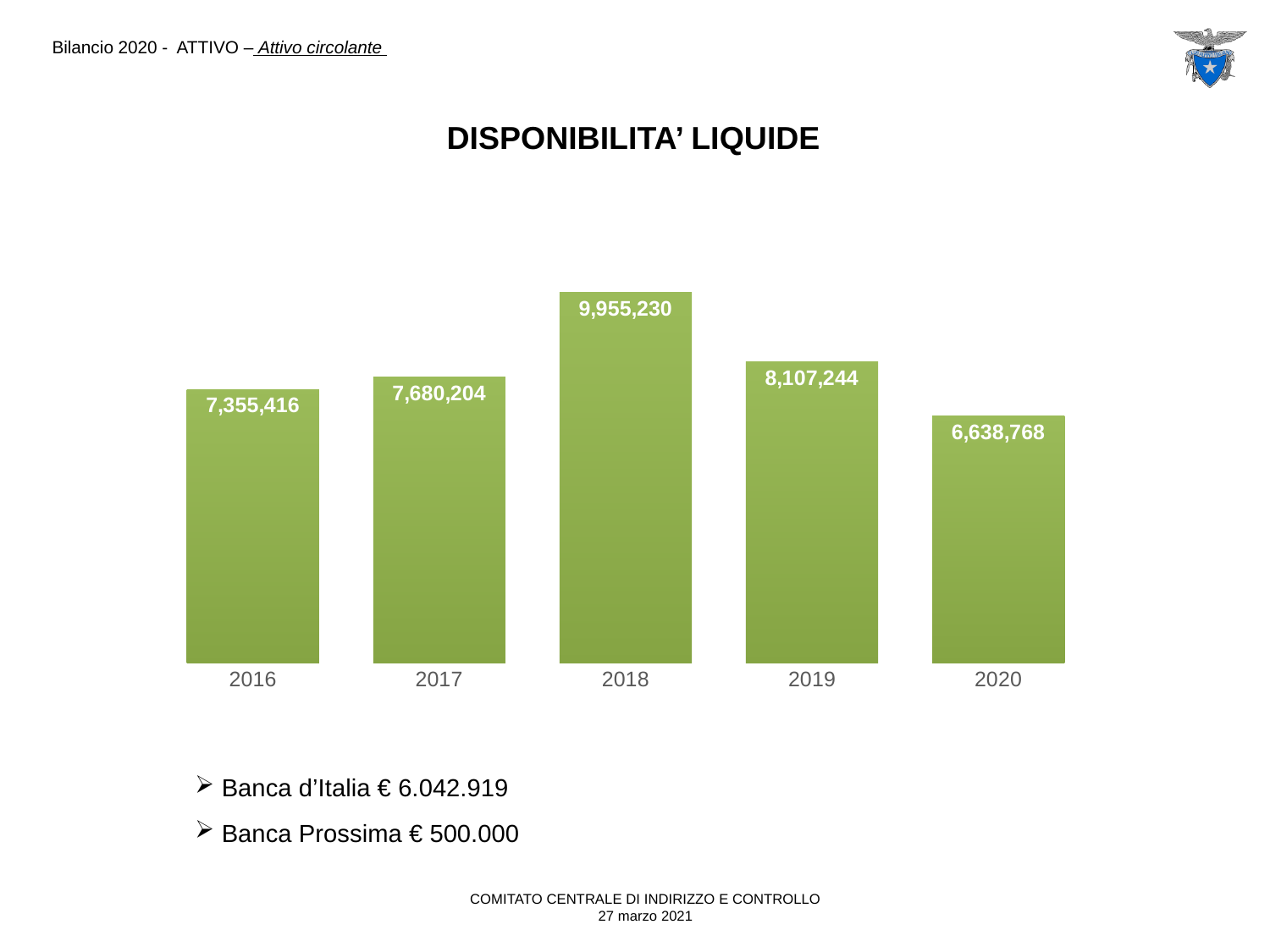
What is the value for 2018 in the DISPONIBILITA' LIQUIDE chart? 9,955,230 Which year has the lowest value in the DISPONIBILITA' LIQUIDE chart? 2020 What is the value for 2020 in the DISPONIBILITA' LIQUIDE chart? 6,638,768 What is the difference between the 2018 and 2019 values in the DISPONIBILITA' LIQUIDE chart? 1,847,986 Which year has the highest value in the DISPONIBILITA' LIQUIDE chart? 2018 How many years are shown in the DISPONIBILITA' LIQUIDE chart? 5 What is the title of the chart on the slide? DISPONIBILITA' LIQUIDE What kind of chart is used for DISPONIBILITA' LIQUIDE? Bar chart How do the values in the DISPONIBILITA' LIQUIDE chart change from 2018 to 2020? They fall What is the value for 2016 in the DISPONIBILITA' LIQUIDE chart? 7,355,416 What is the difference between the 2017 and 2016 values in the DISPONIBILITA' LIQUIDE chart? 324,788 Which is larger in the DISPONIBILITA' LIQUIDE chart, the value for 2019 or the value for 2017? 2019